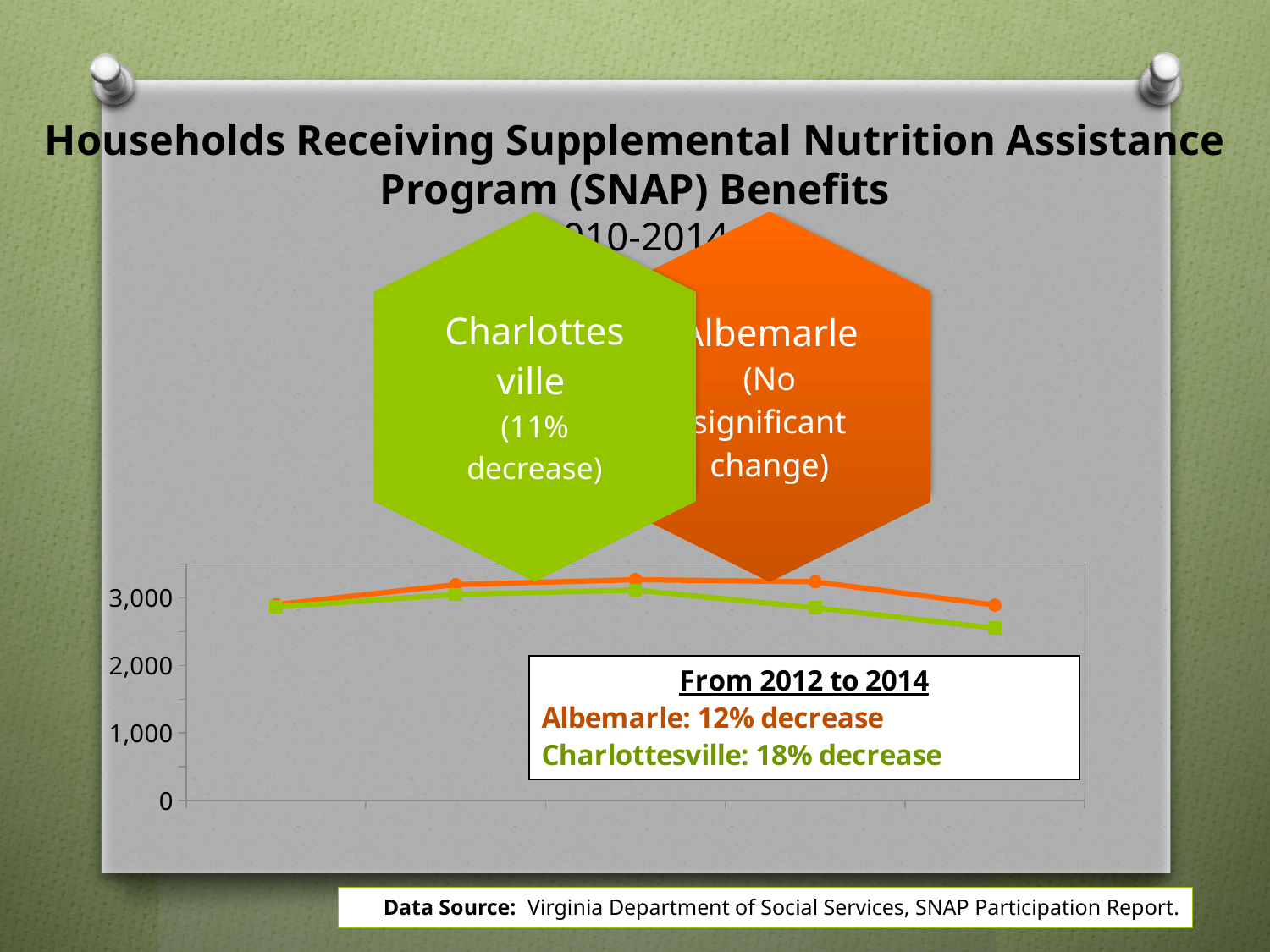
Which colour is used for the Charlottesville line? Green According to the slide, by what percentage did Albemarle decrease from 2012 to 2014? 12% decrease Is the value for Albemarle at the middle (2012) point greater or less than 3,000? greater According to the slide, by what percentage did Charlottesville decrease from 2012 to 2014? 18% decrease Is the value for Charlottesville at the last (2014) point greater or less than 3,000? less Do the lines rise or fall from the middle (2012) point to the last (2014) point? Fall At the last (2014) point, which line is higher, Albemarle or Charlottesville? Albemarle Which colour is used for the Albemarle line? Orange What kind of chart is shown on the slide? Line chart How many data points does each line in the chart have? 5 Which locality had the larger percentage decrease from 2012 to 2014, Albemarle or Charlottesville? Charlottesville How many lines (series) are plotted in the chart? 2